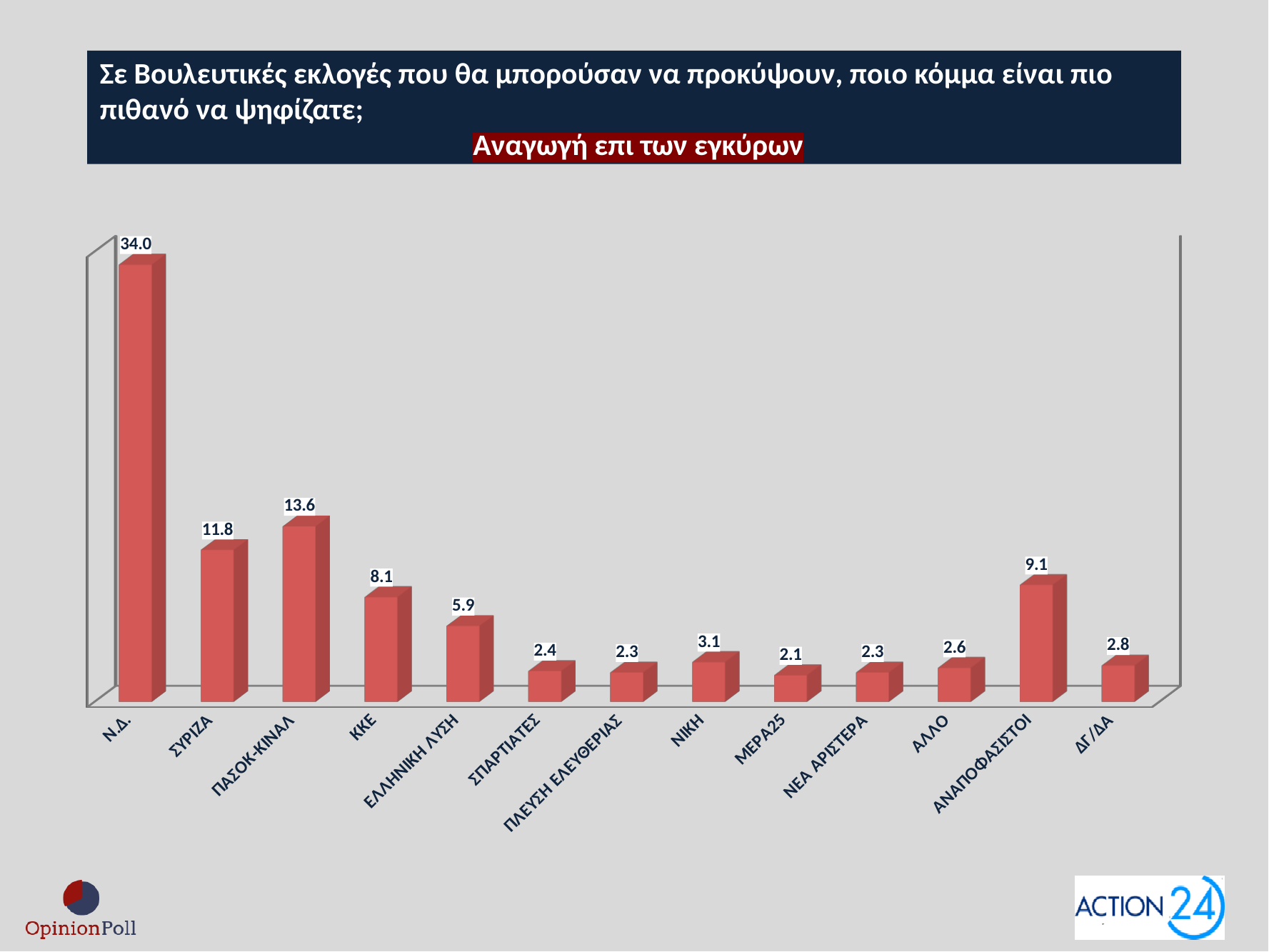
How many categories are shown on the x axis? 13 Which category has the lowest value? ΜΕΡΑ25 What is the value for ΕΛΛΗΝΙΚΗ ΛΥΣΗ? 5.9 What is the difference between the values for Ν.Δ. and ΣΥΡΙΖΑ? 22.2 What is the value for Ν.Δ.? 34.0 What kind of chart is shown on the slide? bar chart What colour are the bars in the chart? red What is the difference between the values for ΠΑΣΟΚ-ΚΙΝΑΛ and ΚΚΕ? 5.5 Which category has the highest value? Ν.Δ. What is the value for ΑΝΑΠΟΦΑΣΙΣΤΟΙ? 9.1 What is the value for ΠΑΣΟΚ-ΚΙΝΑΛ? 13.6 Which is larger, the value for ΣΥΡΙΖΑ or the value for ΠΑΣΟΚ-ΚΙΝΑΛ? ΠΑΣΟΚ-ΚΙΝΑΛ